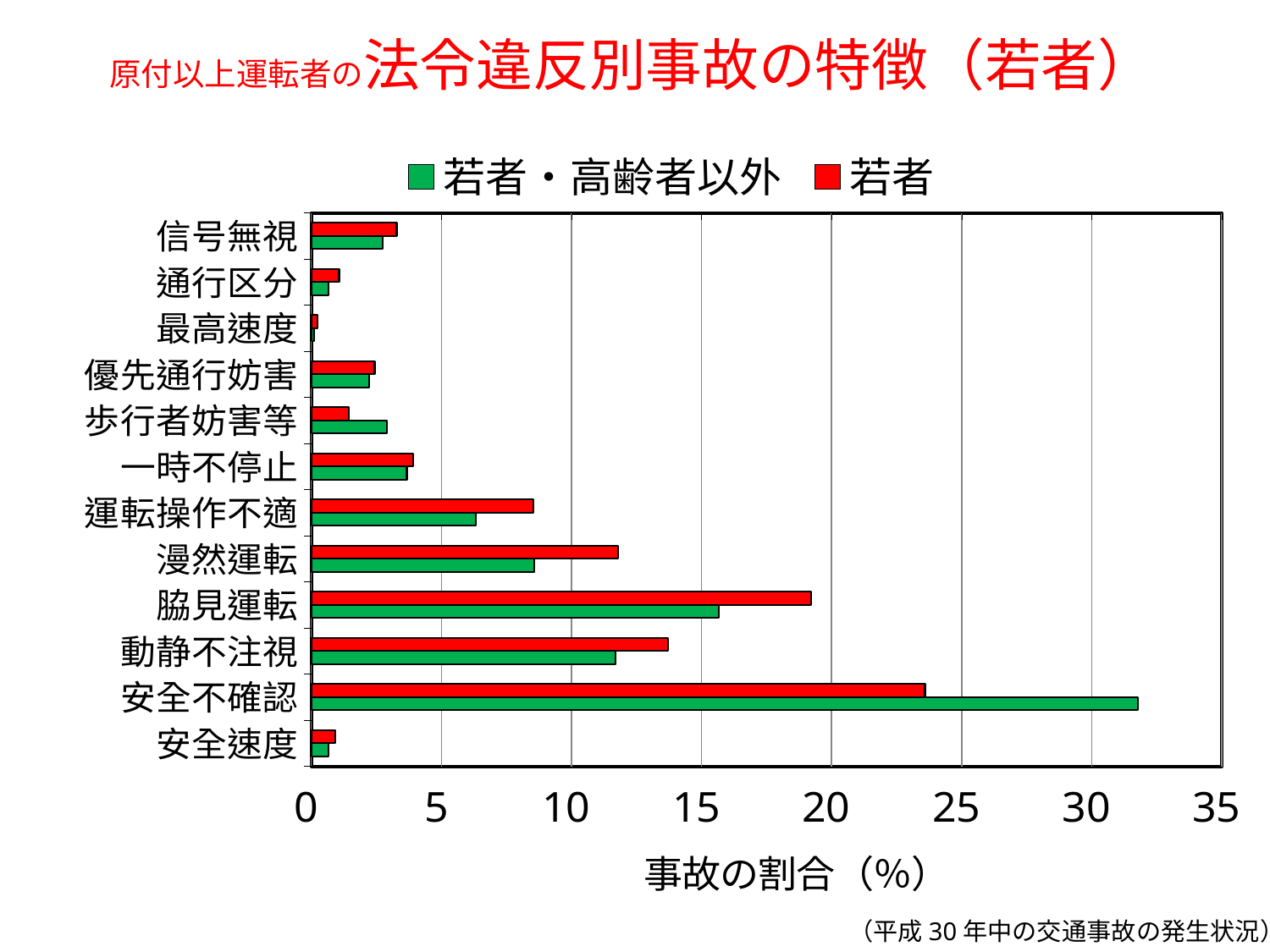
Which category has the highest value for the 若者・高齢者以外 series? 安全不確認 How many series does the legend list? 2 For 脇見運転, which series has the larger value, 若者 or 若者・高齢者以外? 若者 Which category has the lowest value for the 若者 series? 最高速度 For 安全不確認, which series has the larger value, 若者 or 若者・高齢者以外? 若者・高齢者以外 What is the label of the x axis? 事故の割合（%） How many violation categories are plotted on the y axis? 12 Is the 若者 value for 漫然運転 greater or less than 10? greater Which category has the highest value for the 若者 series? 安全不確認 Is the 若者・高齢者以外 value for 安全不確認 greater or less than 30? greater Is the 若者 value for 安全不確認 greater or less than 25? less What kind of chart is shown on the slide? bar chart